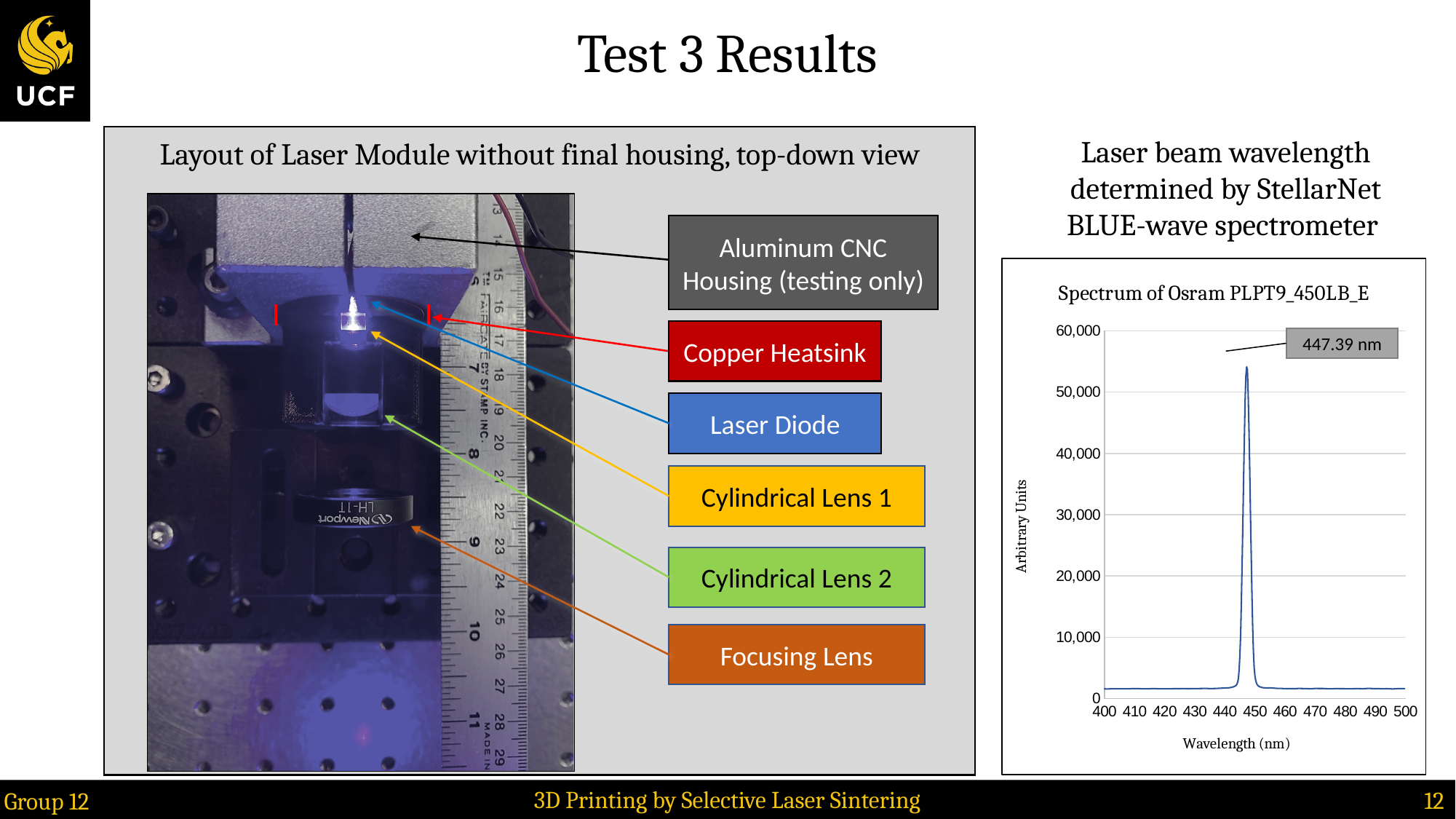
At what wavelength does the spectrum chart's annotation place the peak? 447.39 nm What is the title of the chart on the slide? Spectrum of Osram PLPT9_450LB_E How many tick labels are shown on the x-axis of the spectrum chart? 11 What is the highest tick value on the y-axis of the spectrum chart? 60,000 What is the x-axis label of the spectrum chart? Wavelength (nm) In the spectrum chart, is the peak value greater or less than 60,000? less In the spectrum chart, is the value at 480 nm greater or less than 10,000? less In the spectrum chart, is the peak value greater or less than 50,000? greater What is the highest wavelength shown on the x-axis of the spectrum chart? 500 What is the lowest wavelength shown on the x-axis of the spectrum chart? 400 What kind of chart is shown on the right side of the slide? line chart